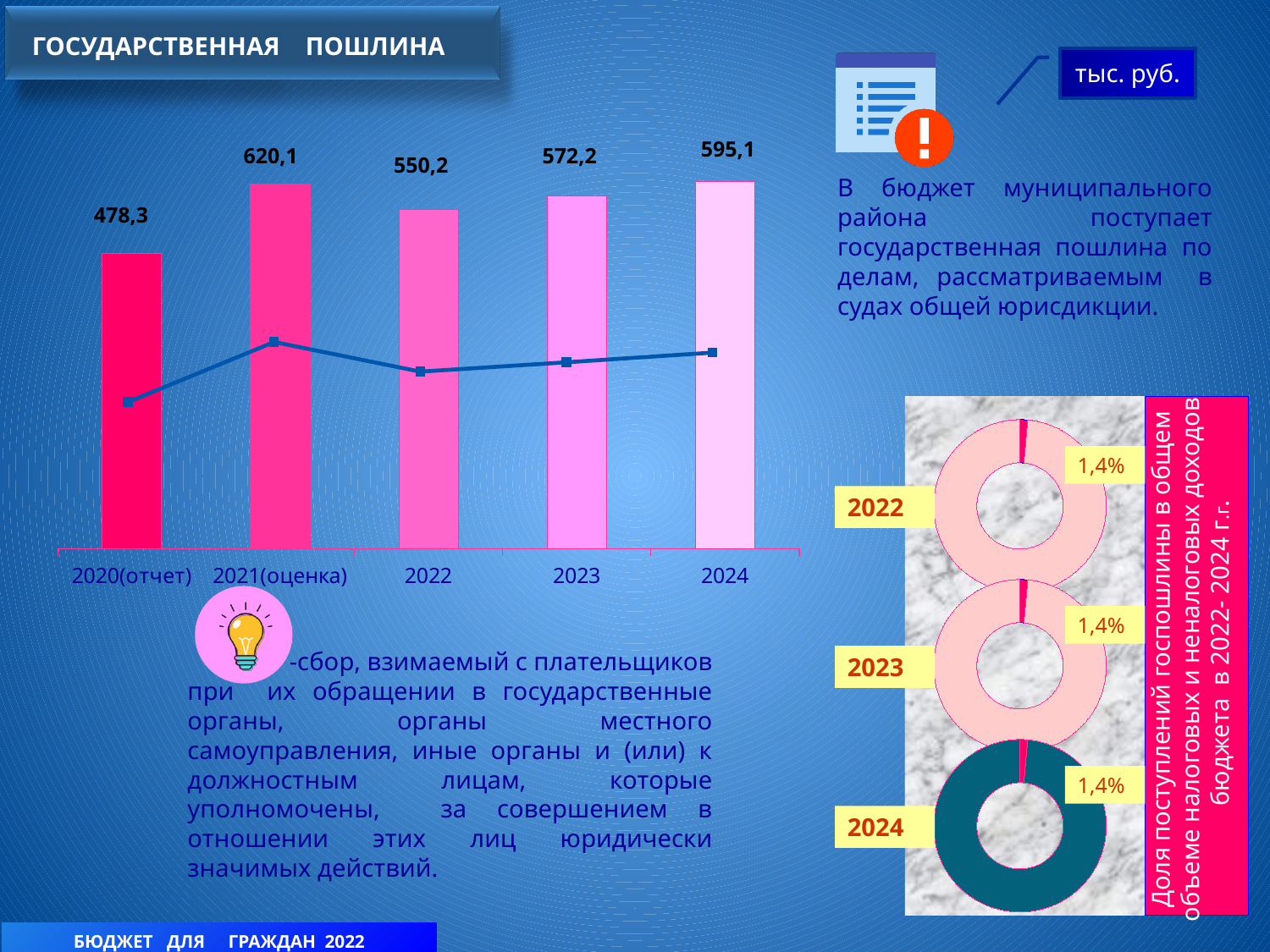
On the bar chart, do the values rise or fall from 2022 to 2024? rise On the bar chart, what is the difference between the values for 2024 and 2023? 22,9 On the bar chart, what is the difference between the values for 2021(оценка) and 2020(отчет)? 141,8 On the bar chart, which year has the lowest value? 2020(отчет) What unit is stated for the values on the slide? тыс. руб. On the bar chart, what is the value for 2021(оценка)? 620,1 How many years are shown on the bar chart? 5 On the bar chart, what is the value for 2024? 595,1 On the bar chart, what is the value for 2020(отчет)? 478,3 On the bar chart, which year has the highest value? 2021(оценка) On the donut charts on the right, what share is shown for 2023? 1,4% On the bar chart, which is larger: the value for 2022 or the value for 2023? 2023